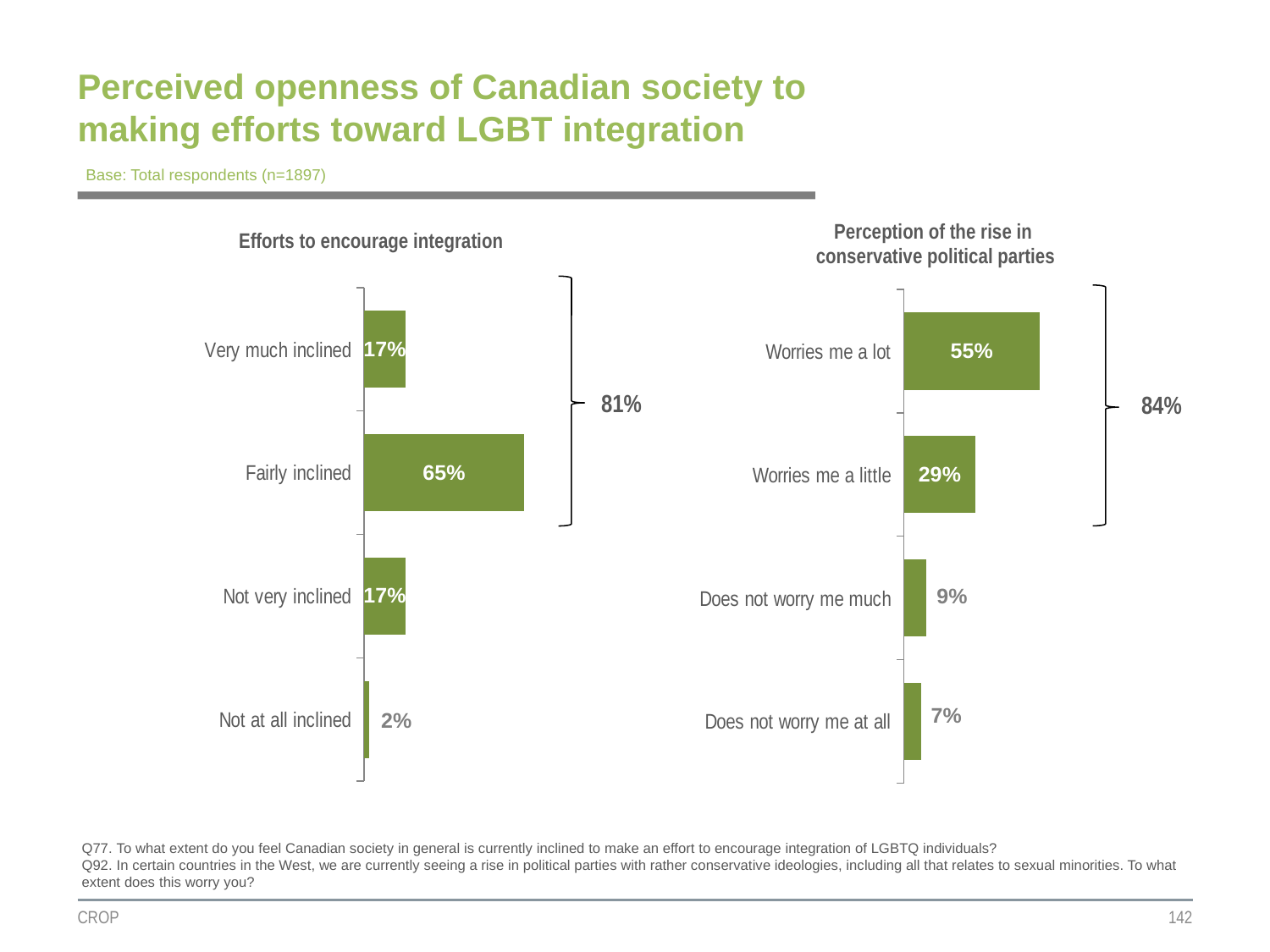
In the 'Efforts to encourage integration' chart, what is the difference between 'Fairly inclined' and 'Very much inclined'? 48% In the 'Perception of the rise in conservative political parties' chart, what is the difference between 'Worries me a lot' and 'Worries me a little'? 26% In the 'Perception of the rise in conservative political parties' chart, what combined value is shown by the bracket for the top two categories? 84% What kind of chart is the 'Perception of the rise in conservative political parties' chart? Bar chart In the 'Perception of the rise in conservative political parties' chart, which category has the lowest value? Does not worry me at all In the 'Efforts to encourage integration' chart, which category has the highest value? Fairly inclined In the 'Efforts to encourage integration' chart, what is the value for 'Fairly inclined'? 65% How many categories are shown in the 'Efforts to encourage integration' chart? 4 In the 'Perception of the rise in conservative political parties' chart, which is larger: 'Does not worry me much' or 'Does not worry me at all'? Does not worry me much In the 'Efforts to encourage integration' chart, what is the value for 'Not at all inclined'? 2% In the 'Perception of the rise in conservative political parties' chart, what is the value for 'Worries me a lot'? 55% In the 'Perception of the rise in conservative political parties' chart, what is the value for 'Does not worry me much'? 9%